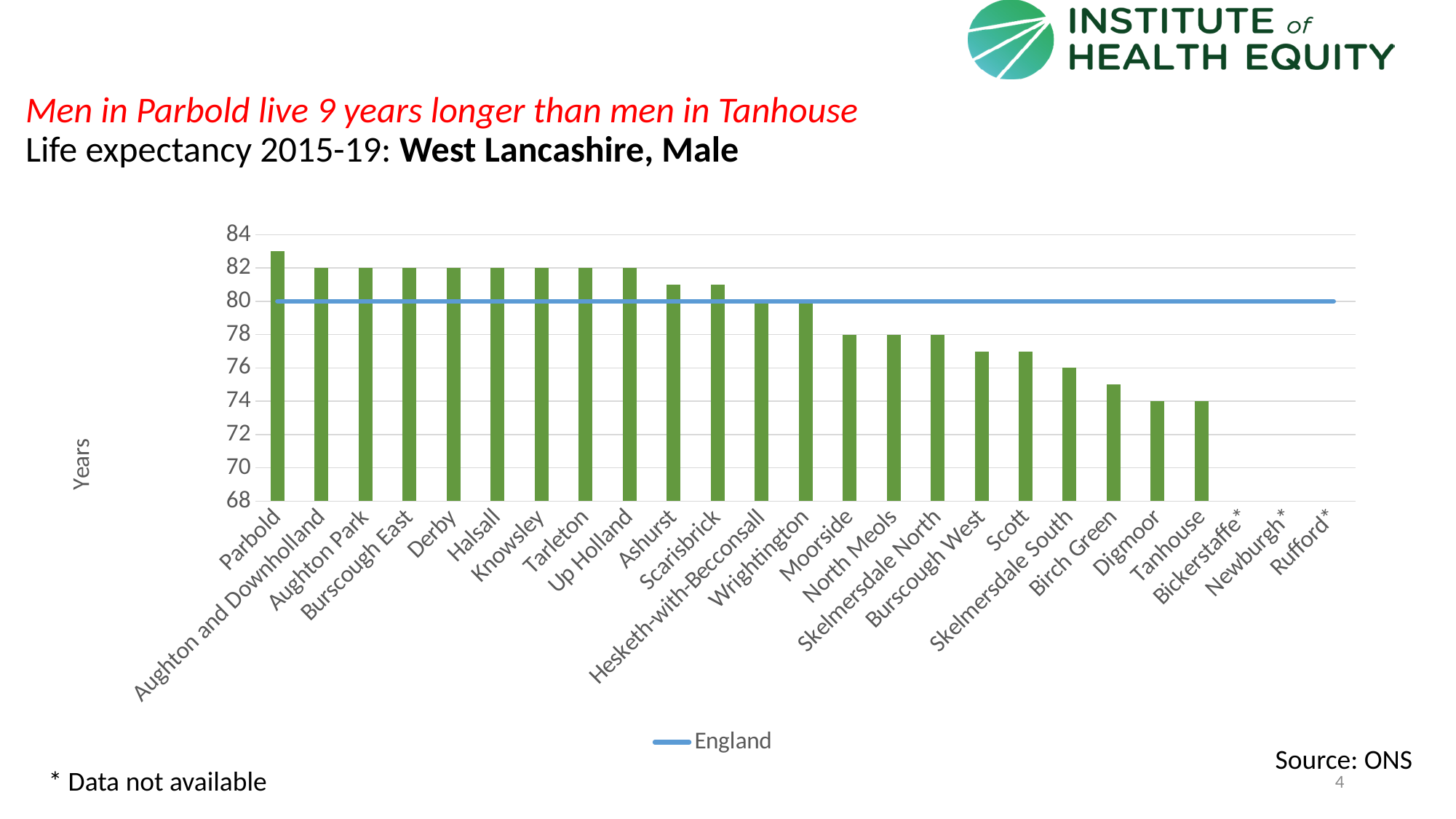
What value does the England line sit at? 80 Is the value for Birch Green greater or less than 76? less What type of chart is shown on the slide? Bar chart Is the value for Parbold greater or less than 82? greater What is the male life expectancy for Skelmersdale South? 76 What is the male life expectancy for Moorside? 78 What is the difference in life expectancy between Aughton Park and Tanhouse? 8 What is the male life expectancy for Aughton Park? 82 How many wards are marked with an asterisk as having no data available? 3 Which ward has the highest male life expectancy in the chart? Parbold What is the male life expectancy for Tanhouse? 74 Which has the higher male life expectancy, Derby or Digmoor? Derby